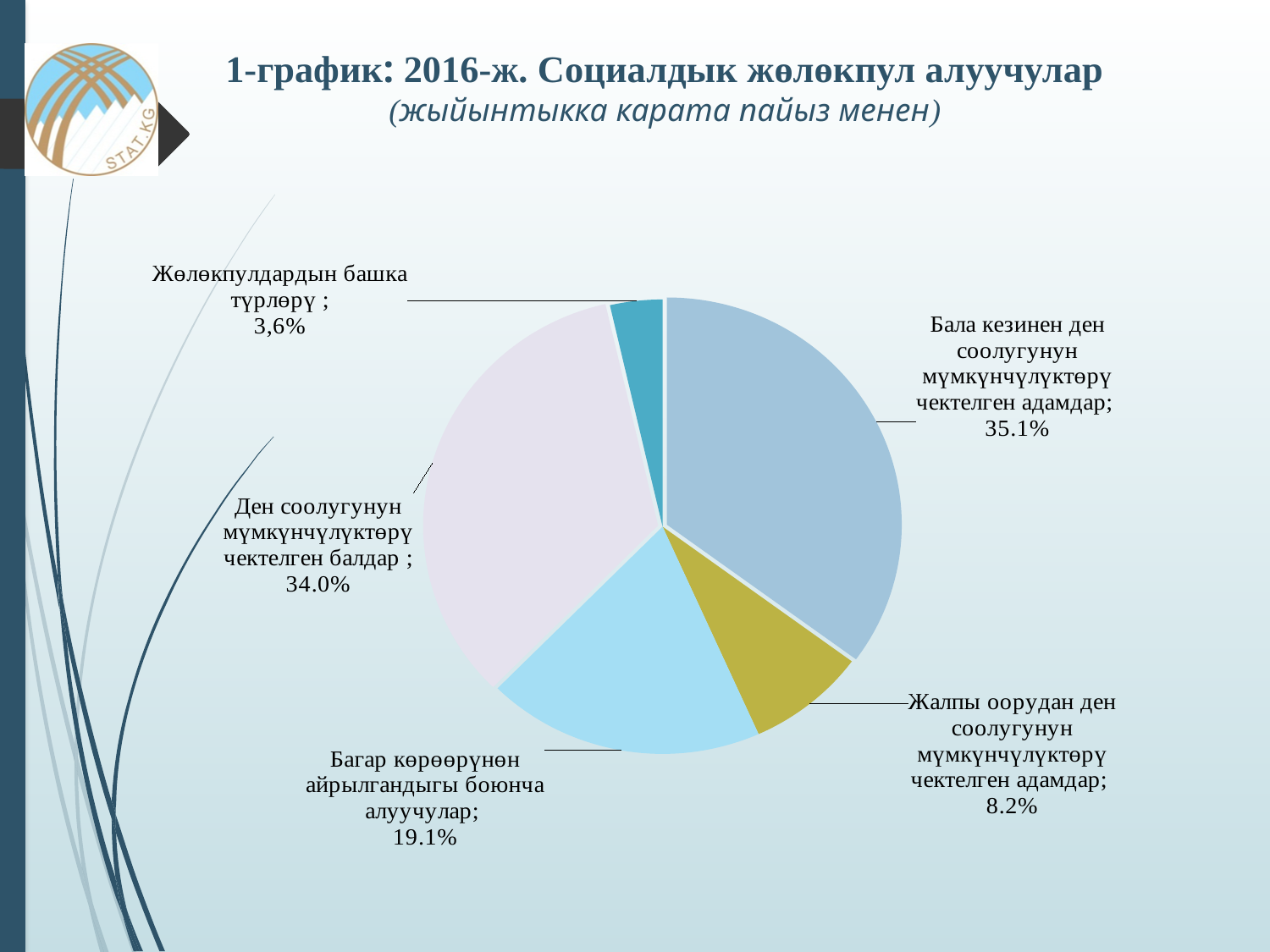
What is the difference in percentage points between the share for 'Багар көрөөрүнөн айрылгандыгы боюнча алуучулар' and the share for 'Жалпы оорудан ден соолугунун мүмкүнчүлүктөрү чектелген адамдар'? 10.9 Which category has the largest share of the pie? Бала кезинен ден соолугунун мүмкүнчүлүктөрү чектелген адамдар What year does the chart title refer to? 2016 How many slices does the pie chart have? 5 What type of chart is shown on the slide? pie chart What is the share for 'Жөлөкпулдардын башка түрлөрү'? 3,6% What is the share for 'Бала кезинен ден соолугунун мүмкүнчүлүктөрү чектелген адамдар'? 35.1% What is the share for 'Жалпы оорудан ден соолугунун мүмкүнчүлүктөрү чектелген адамдар'? 8.2% What is the share for 'Ден соолугунун мүмкүнчүлүктөрү чектелген балдар'? 34.0% Which is larger: the share for 'Багар көрөөрүнөн айрылгандыгы боюнча алуучулар' or for 'Жалпы оорудан ден соолугунун мүмкүнчүлүктөрү чектелген адамдар'? Багар көрөөрүнөн айрылгандыгы боюнча алуучулар Which category has the smallest share of the pie? Жөлөкпулдардын башка түрлөрү What is the share for 'Багар көрөөрүнөн айрылгандыгы боюнча алуучулар'? 19.1%